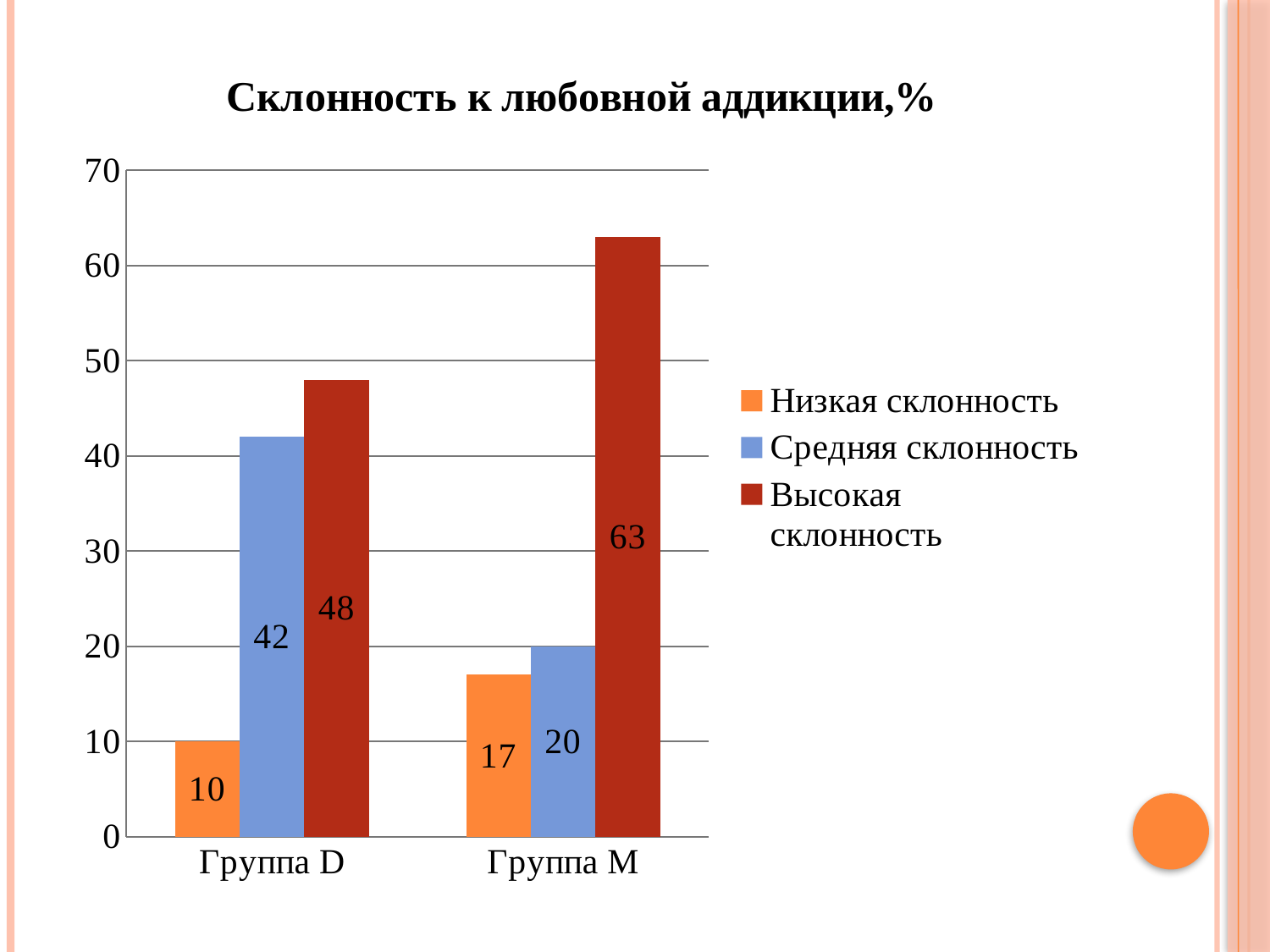
What is the difference between Высокая склонность in Группа M and Группа D? 15 What is the value for Средняя склонность in Группа D? 42 What is the value for Высокая склонность in Группа M? 63 Which is larger: Средняя склонность in Группа D or Средняя склонность in Группа M? Группа D How many series does the legend list? 3 How many groups are shown on the x axis? 2 Is the value for Высокая склонность in Группа M greater or less than 60? greater Which group has the highest value for Высокая склонность? Группа M Which series has the lowest value in Группа M? Низкая склонность What kind of chart is shown on the slide? bar chart What is the value for Низкая склонность in Группа D? 10 What is the value for Средняя склонность in Группа M? 20